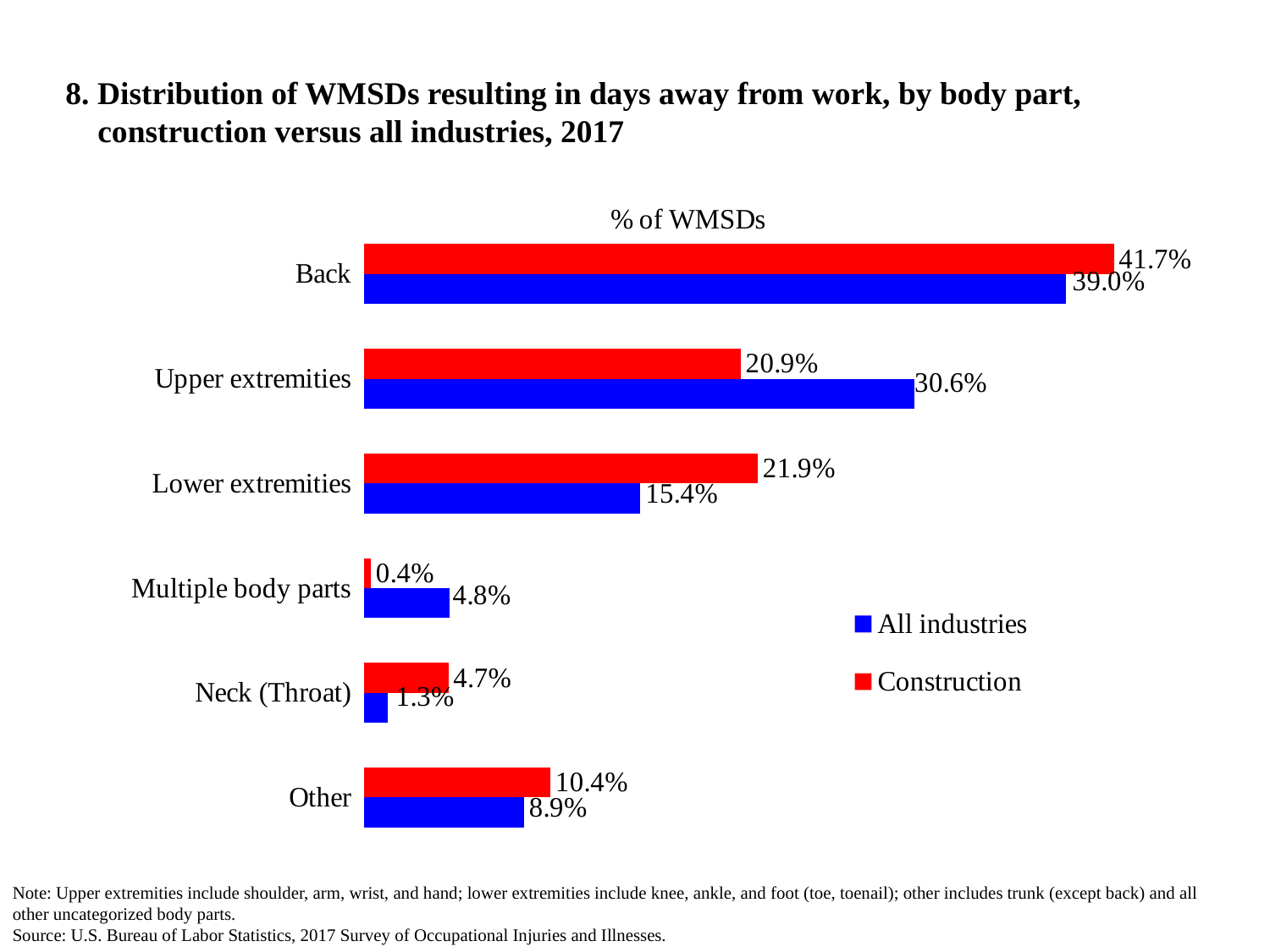
How many body part categories are shown on the chart? 6 Which body part has the lowest share of WMSDs in the All industries series? Neck (Throat) What is the Construction value for Multiple body parts? 0.4% For Upper extremities, which series has the larger value, Construction or All industries? All industries Which colour represents the Construction series? Red What is the difference between the Construction and All industries values for Lower extremities? 6.5% What percentage of WMSDs in construction are attributed to the back? 41.7% What kind of chart is shown on the slide? Bar chart What is the value for Upper extremities in the All industries series? 30.6% How many series does the legend list? 2 Which body part has the highest share of WMSDs in the Construction series? Back What is the All industries value for Neck (Throat)? 1.3%